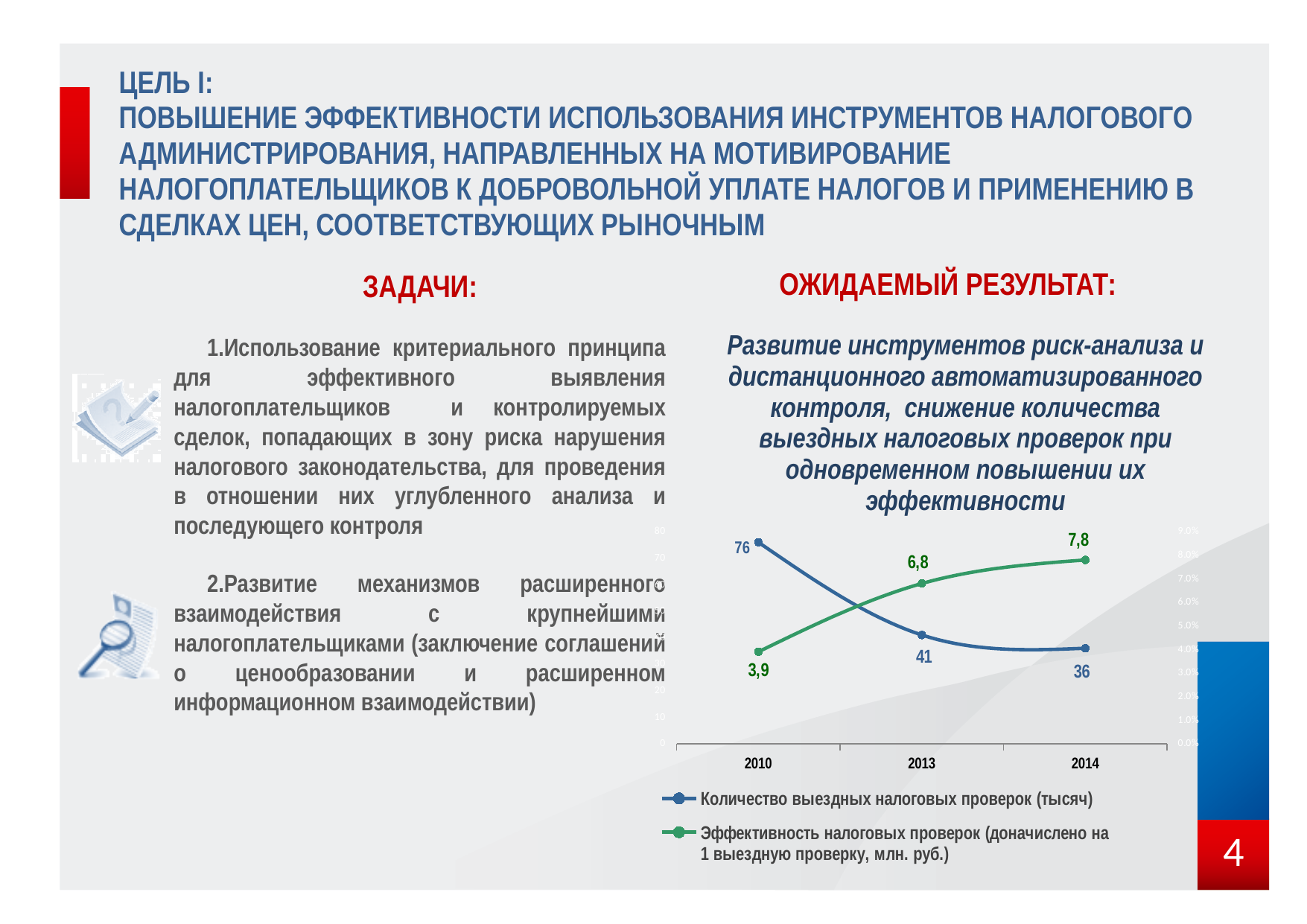
What is the value of 'Эффективность налоговых проверок' in 2010? 3,9 What is the value of 'Количество выездных налоговых проверок (тысяч)' in 2014? 36 In which year is 'Эффективность налоговых проверок' the highest? 2014 What type of chart is shown on the slide? line chart By how much did 'Эффективность налоговых проверок' increase from 2010 to 2014? 3,9 What is the value of 'Эффективность налоговых проверок' in 2013? 6,8 How many years are plotted on the x axis of the chart? 3 By how much did 'Количество выездных налоговых проверок (тысяч)' fall from 2010 to 2014? 40 In which year is 'Количество выездных налоговых проверок (тысяч)' the lowest? 2014 Does 'Количество выездных налоговых проверок (тысяч)' rise or fall from 2010 to 2014? fall What is the value of 'Количество выездных налоговых проверок (тысяч)' in 2010? 76 How many series does the chart legend list? 2